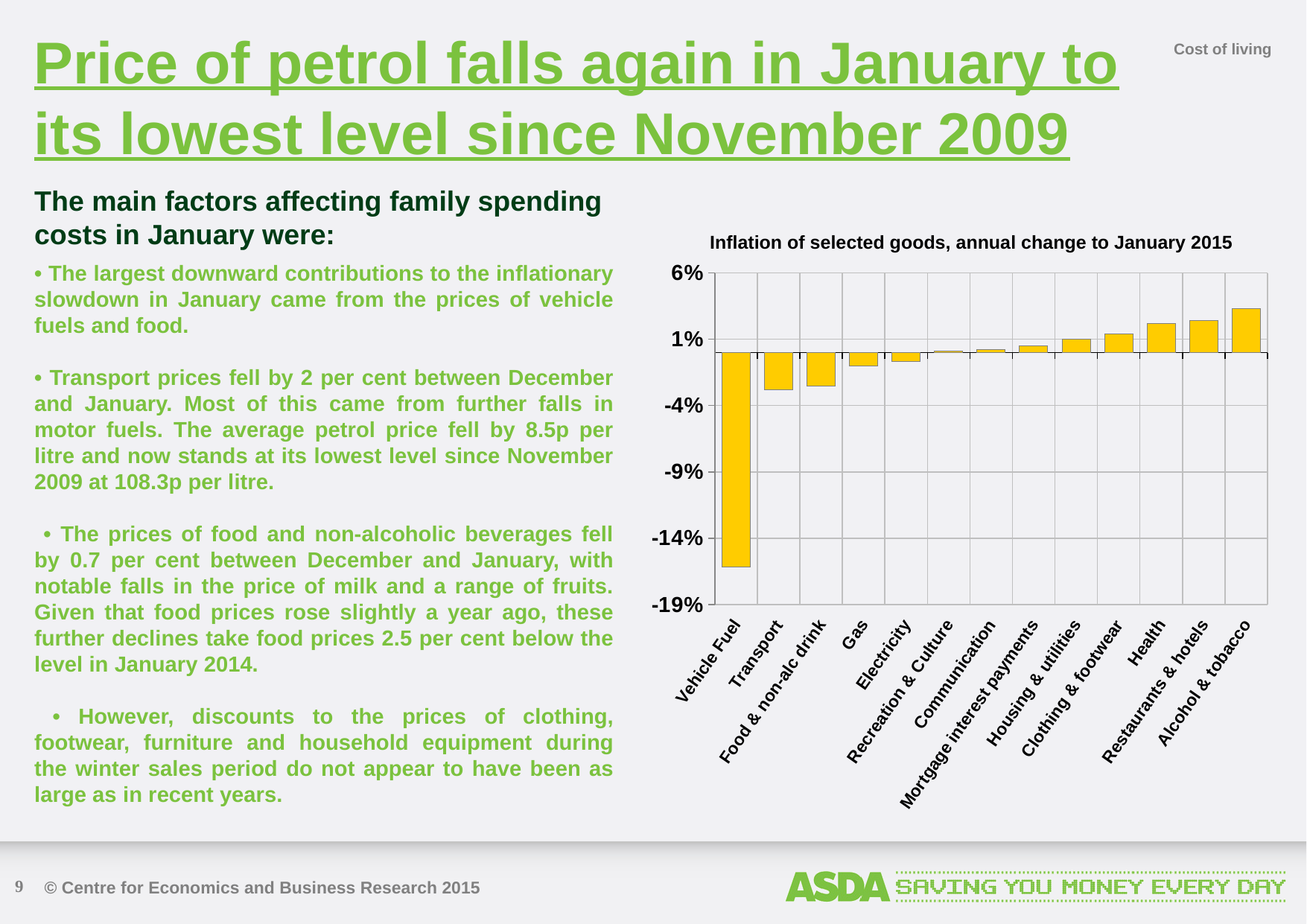
Is the value for Health greater or less than 1%? greater Which category has the lowest value in the chart? Vehicle Fuel Do the values generally rise or fall moving from left to right along the x axis? Rise What is the title of the chart? Inflation of selected goods, annual change to January 2015 Which category has the highest value in the chart? Alcohol & tobacco Is the value for Vehicle Fuel greater or less than -14%? less Which has the larger value, Vehicle Fuel or Transport? Transport Is the value for Transport greater or less than -4%? greater Which has the larger value, Alcohol & tobacco or Health? Alcohol & tobacco How many categories are plotted in the chart? 13 What kind of chart is shown on the slide? Bar chart